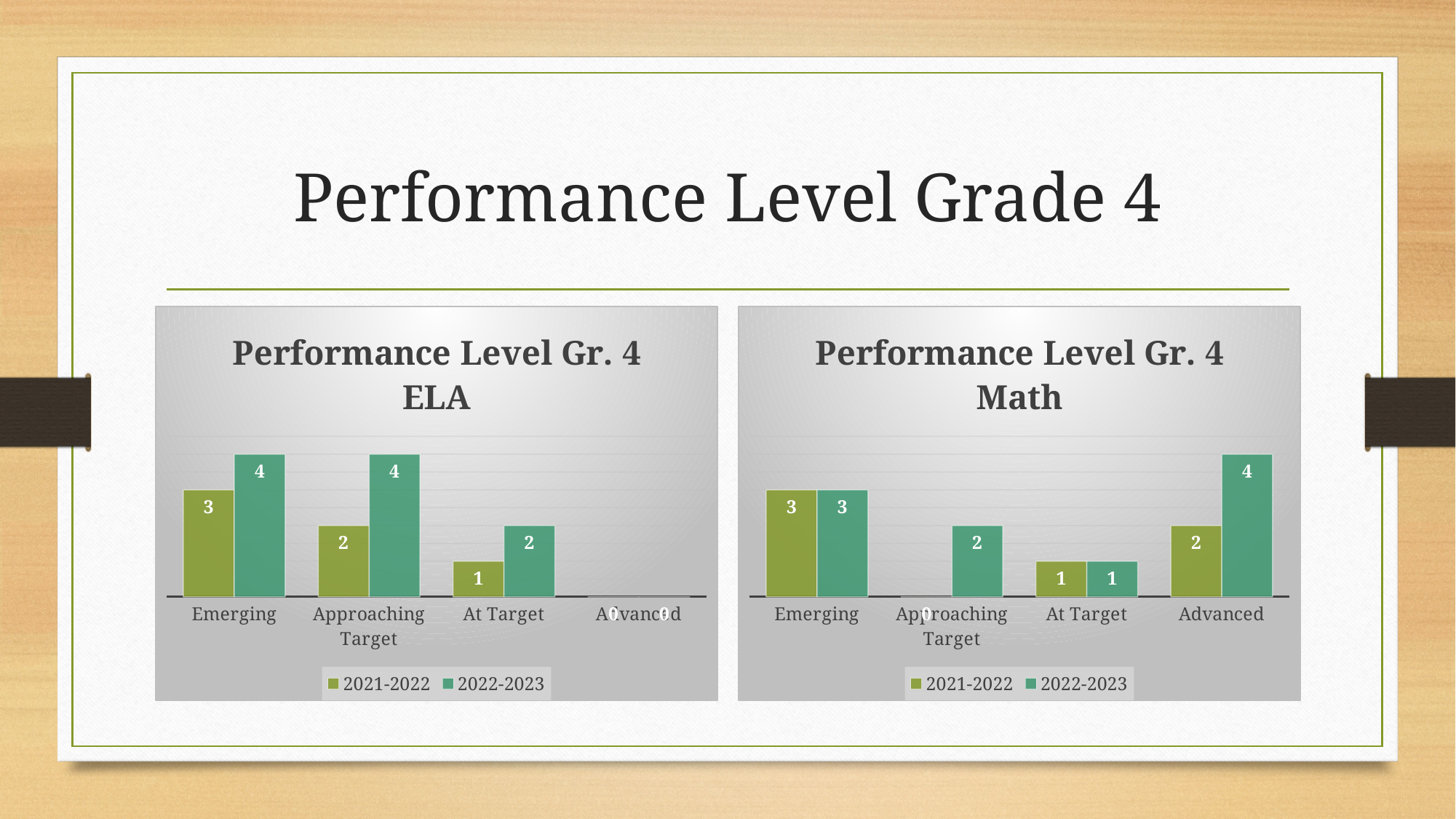
How many series does the legend of the Performance Level Gr. 4 Math chart list? 2 In the Performance Level Gr. 4 Math chart, which is larger for Emerging: the 2021-2022 value or the 2022-2023 value? They are equal In the Performance Level Gr. 4 Math chart, what is the value for Approaching Target in 2022-2023? 2 In the Performance Level Gr. 4 Math chart, which category has the highest value for 2022-2023? Advanced In the Performance Level Gr. 4 ELA chart, what is the value for Emerging in 2022-2023? 4 In the Performance Level Gr. 4 Math chart, what is the difference between the 2022-2023 and 2021-2022 values for Advanced? 2 In the Performance Level Gr. 4 Math chart, what is the value for Advanced in 2022-2023? 4 In the Performance Level Gr. 4 ELA chart, which category has the lowest value for 2021-2022? Advanced How many categories are shown on the x axis of the Performance Level Gr. 4 ELA chart? 4 What kind of chart is the Performance Level Gr. 4 Math chart? Bar chart In the Performance Level Gr. 4 ELA chart, what is the value for At Target in 2021-2022? 1 In the Performance Level Gr. 4 ELA chart, what is the difference between the 2022-2023 and 2021-2022 values for Approaching Target? 2